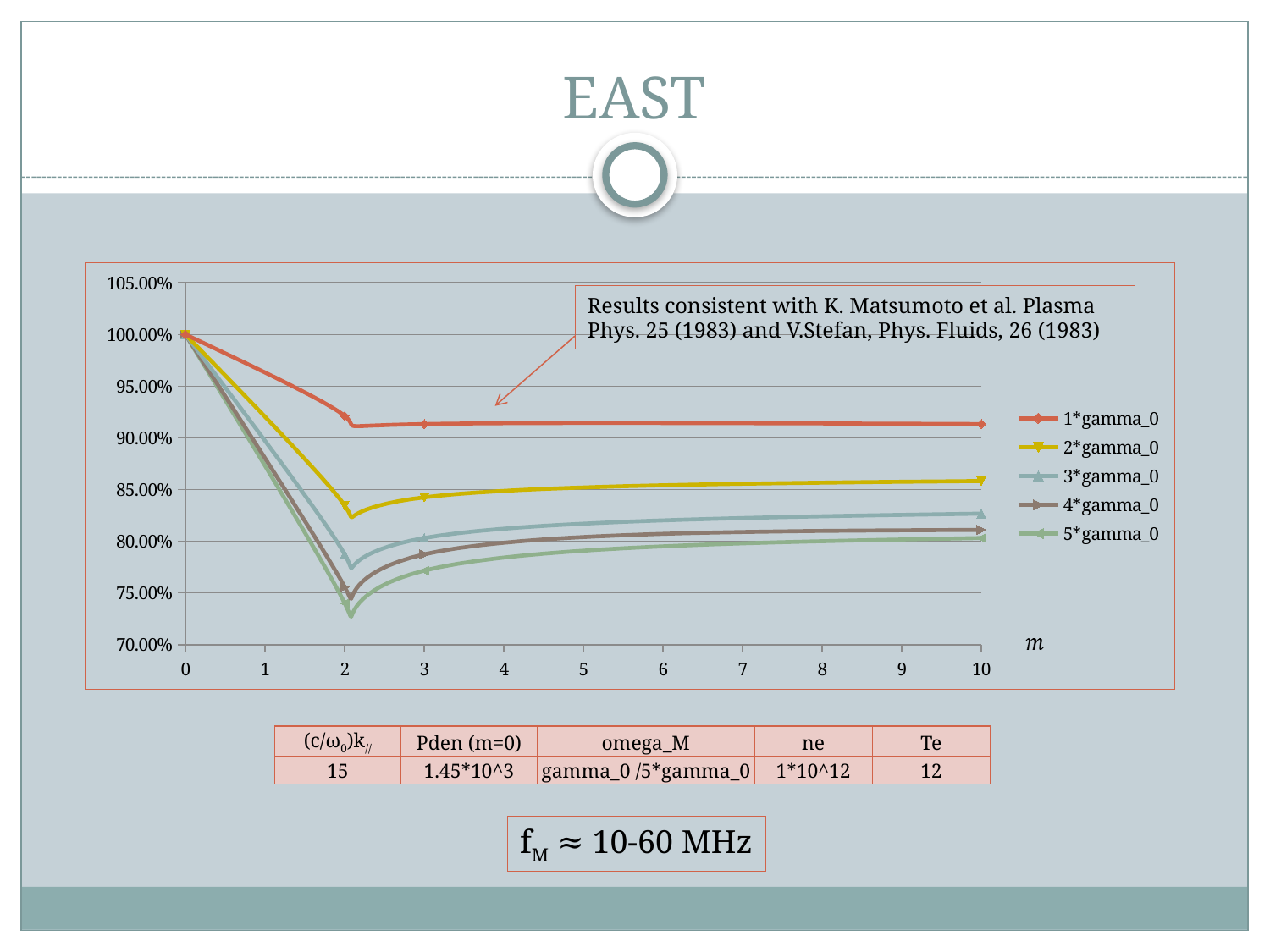
What kind of chart is shown on the slide? line chart What label is shown on the x axis of the chart? m Is the value for 4*gamma_0 at m = 10 greater or less than 85.00%? less What is the value of the 1*gamma_0 series at m = 0? 100.00% At m = 3, which is larger: the value for 2*gamma_0 or the value for 3*gamma_0? 2*gamma_0 Do the values of the 3*gamma_0 series rise or fall between m = 0 and m = 2? fall Is the value for 5*gamma_0 at m = 2 greater or less than 75.00%? less What is the last entry listed in the chart legend? 5*gamma_0 Is the value for 1*gamma_0 at m = 10 greater or less than 90.00%? greater Which series has the lowest value at m = 2? 5*gamma_0 Which series has the highest value at m = 10? 1*gamma_0 How many series does the legend list? 5